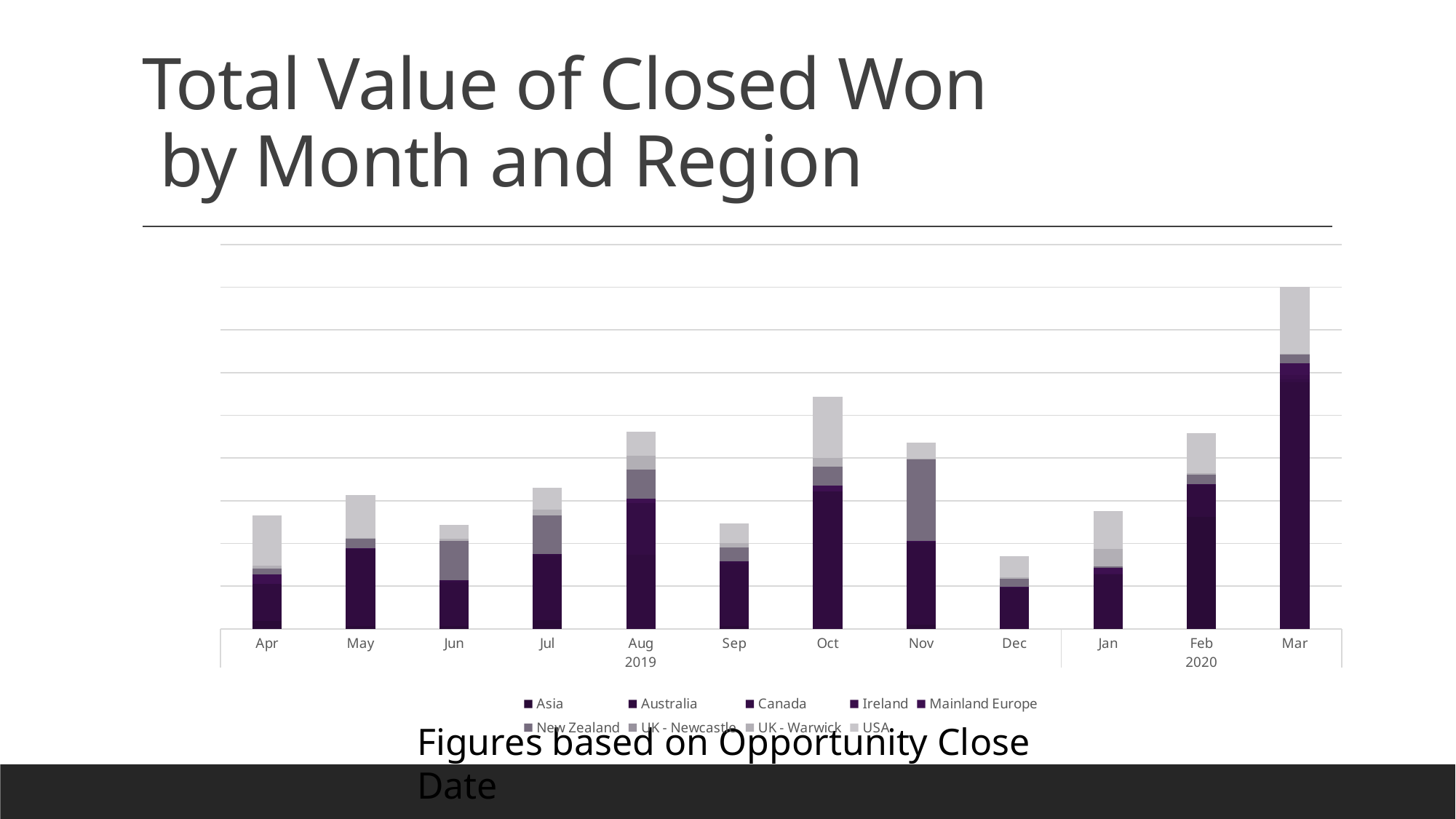
Which month has the taller stacked bar, Jun or Jul? Jul Which month has the taller stacked bar, Aug or Sep? Aug Which month has the tallest stacked bar? Mar Which month has the taller stacked bar, Feb or Jan? Feb Do the stacked bar totals rise or fall from Dec to Mar? Rise How many regions does the legend list? 9 What is the title of the slide's chart? Total Value of Closed Won by Month and Region Which month has the shortest stacked bar? Dec What kind of chart is shown on the slide? Stacked bar chart How many months are plotted along the x axis? 12 Which two years are labelled on the x axis? 2019 and 2020